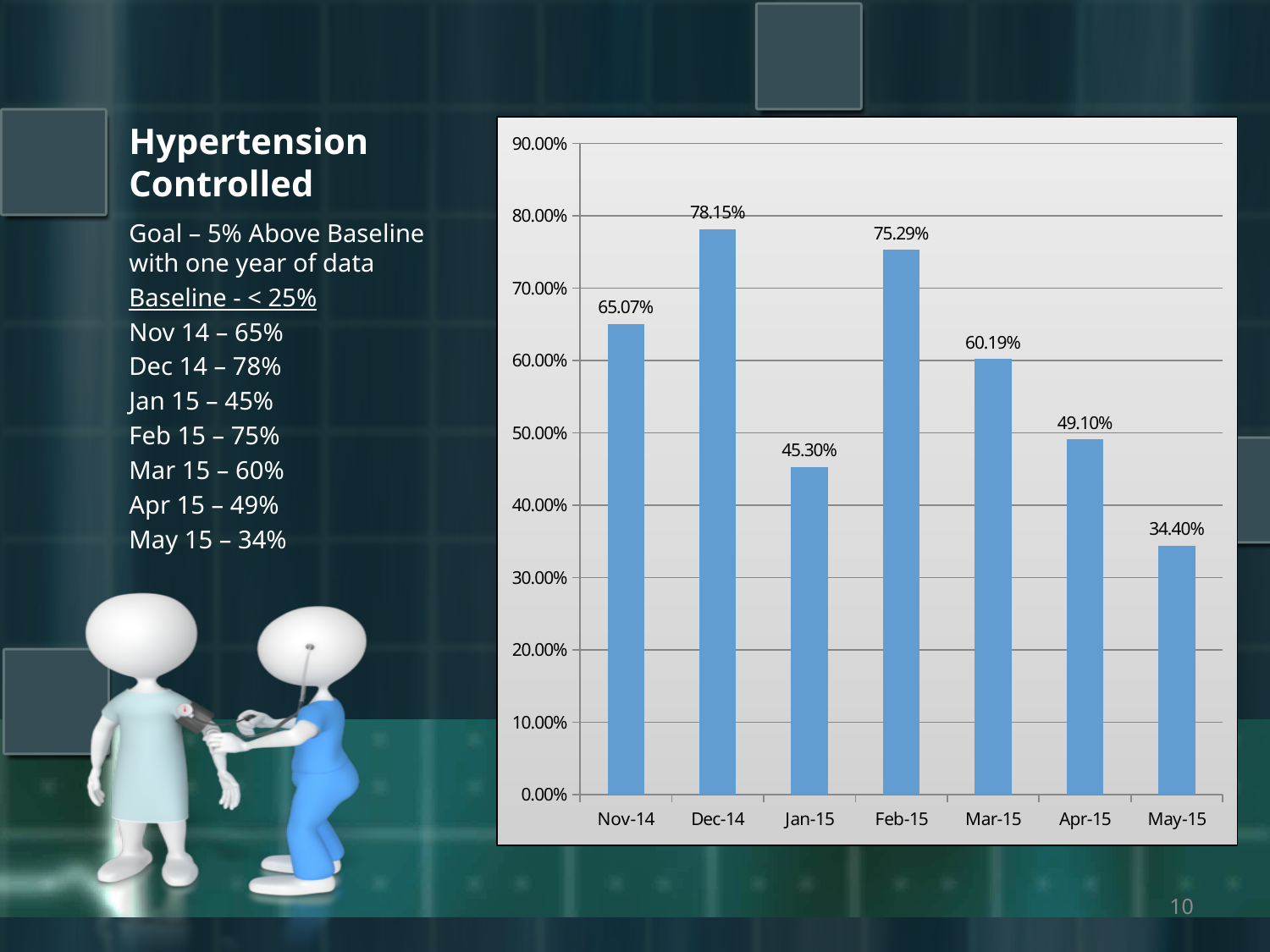
How many months are shown on the x axis? 7 What is the difference between the values for Dec-14 and Feb-15? 2.86% What is the value for Jan-15? 45.30% What kind of chart is shown on the slide? bar chart Do the values rise or fall from Feb-15 to May-15? fall Which month has the lowest value? May-15 What is the value for May-15? 34.40% What is the difference between the values for Nov-14 and May-15? 30.67% Which is larger, the value for Mar-15 or the value for Apr-15? Mar-15 Which month has the highest value? Dec-14 Is the value for Feb-15 greater or less than 70.00%? greater What is the value for Dec-14? 78.15%